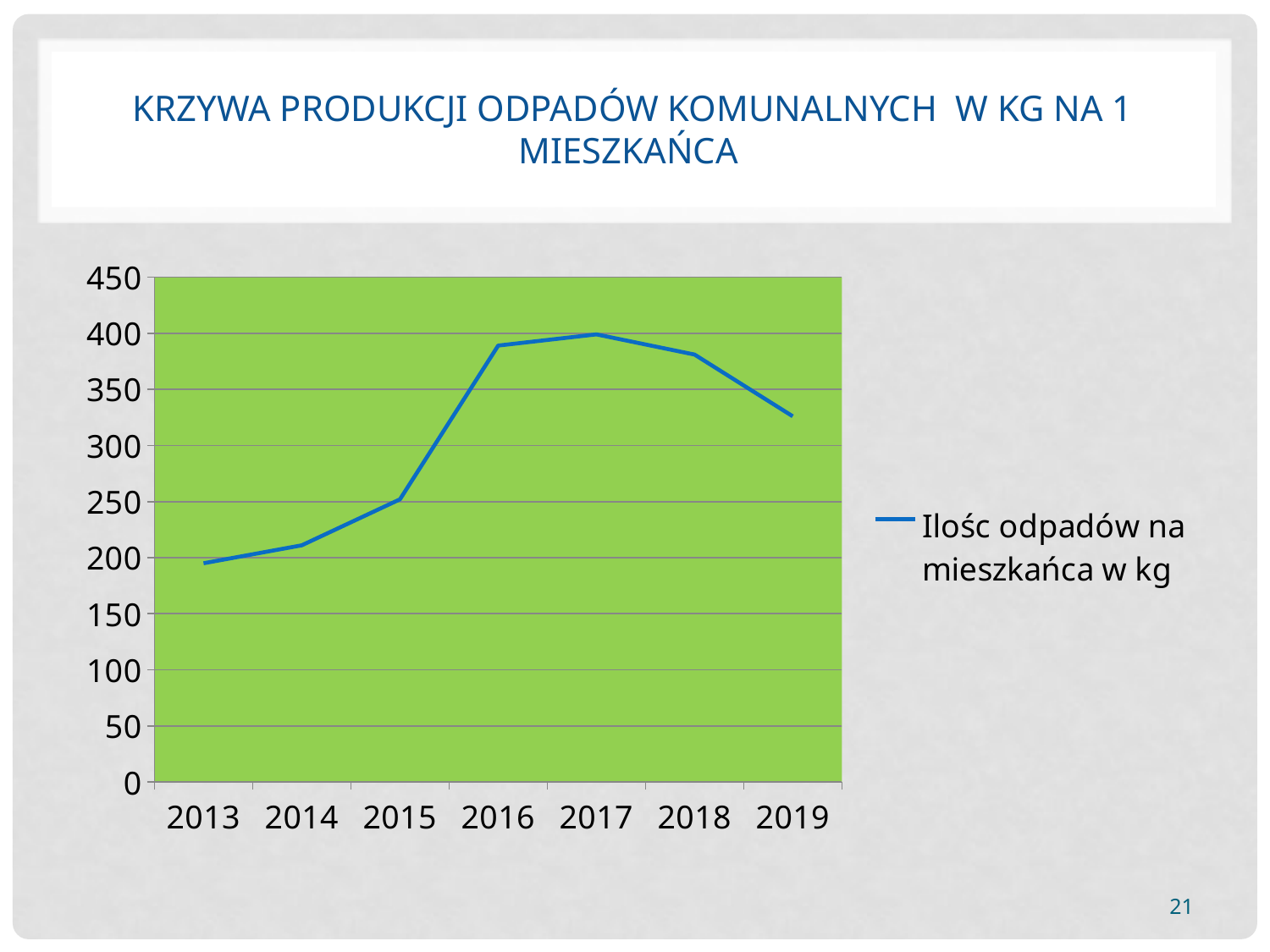
Which year has the larger value, 2015 or 2016? 2016 Is the value for 2016 greater or less than 350? greater What kind of chart is shown on the slide? line chart Is the value for 2019 greater or less than 350? less How many years are plotted along the x axis? 7 Which year has the highest value? 2017 Is the value for 2015 greater or less than 200? greater Which year has the lowest value? 2013 What is the legend entry for the plotted series? Ilośc odpadów na mieszkańca w kg How many series does the legend list? 1 Do the values rise or fall from 2017 to 2019? fall